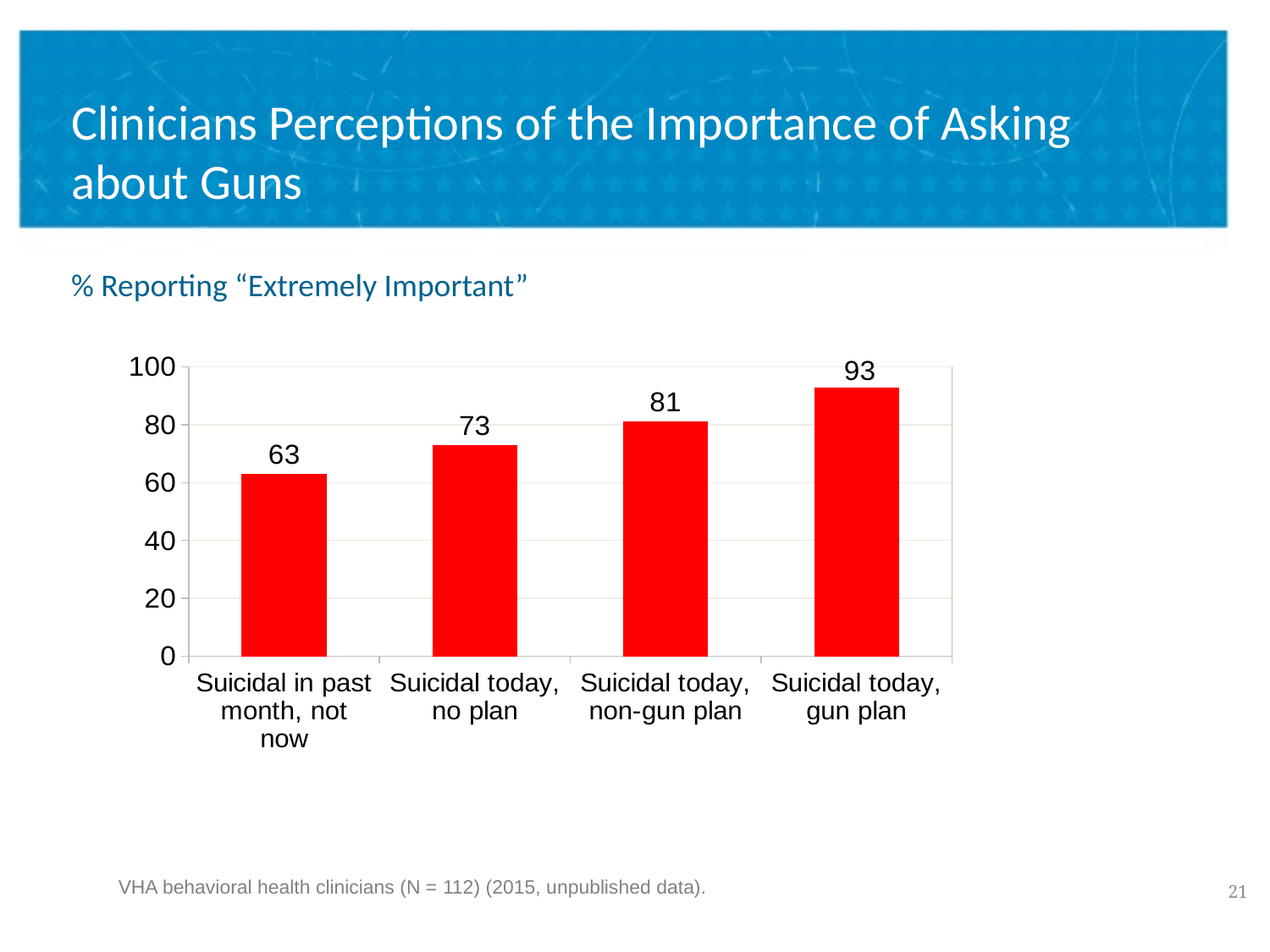
What percentage of clinicians reported asking about guns as "Extremely Important" for the "Suicidal today, gun plan" category? 93 What is the value for "Suicidal in past month, not now"? 63 Is the value for "Suicidal today, no plan" greater or less than 80? less Which is larger: the value for "Suicidal today, no plan" or "Suicidal today, non-gun plan"? Suicidal today, non-gun plan What kind of chart is shown on the slide? Bar chart Do the values rise or fall from left to right across the categories? Rise Which category has the lowest value? Suicidal in past month, not now How many categories are shown on the chart? 4 What is the value for "Suicidal today, non-gun plan"? 81 What is the difference between the values for "Suicidal today, gun plan" and "Suicidal in past month, not now"? 30 What is the value for "Suicidal today, no plan"? 73 Which category has the highest value? Suicidal today, gun plan